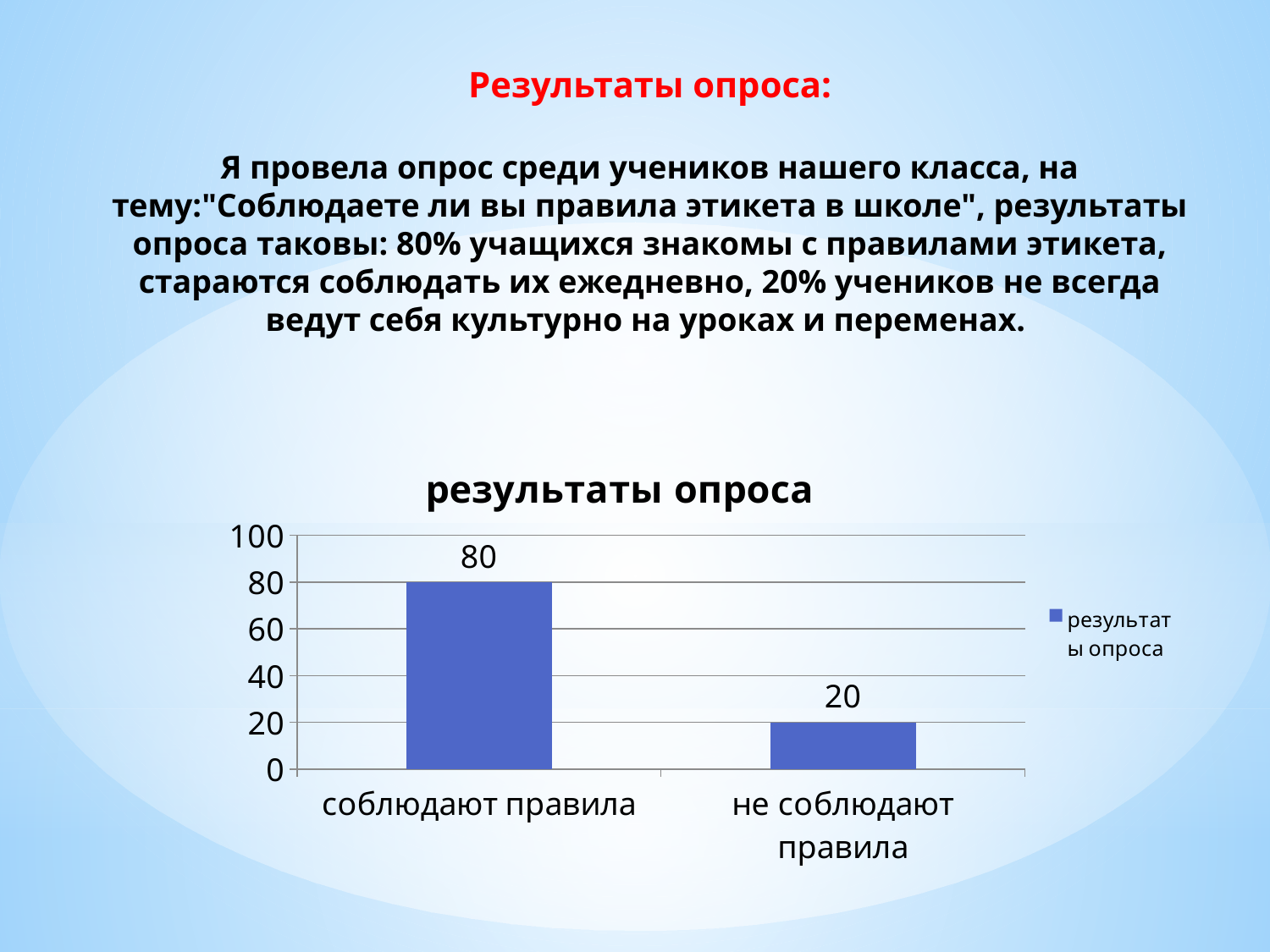
What kind of chart is shown? bar chart Is the value for "соблюдают правила" greater or less than 60? greater Which category has the highest value? соблюдают правила What is the difference between the values for "соблюдают правила" and "не соблюдают правила"? 60 What is the title of the chart? результаты опроса Is the value for "не соблюдают правила" greater or less than 40? less What is the value for "не соблюдают правила"? 20 How many categories are shown on the x axis? 2 Which category has the lowest value? не соблюдают правила What is the value for "соблюдают правила"? 80 How many series does the legend list? 1 Which is larger: the value for "соблюдают правила" or for "не соблюдают правила"? соблюдают правила